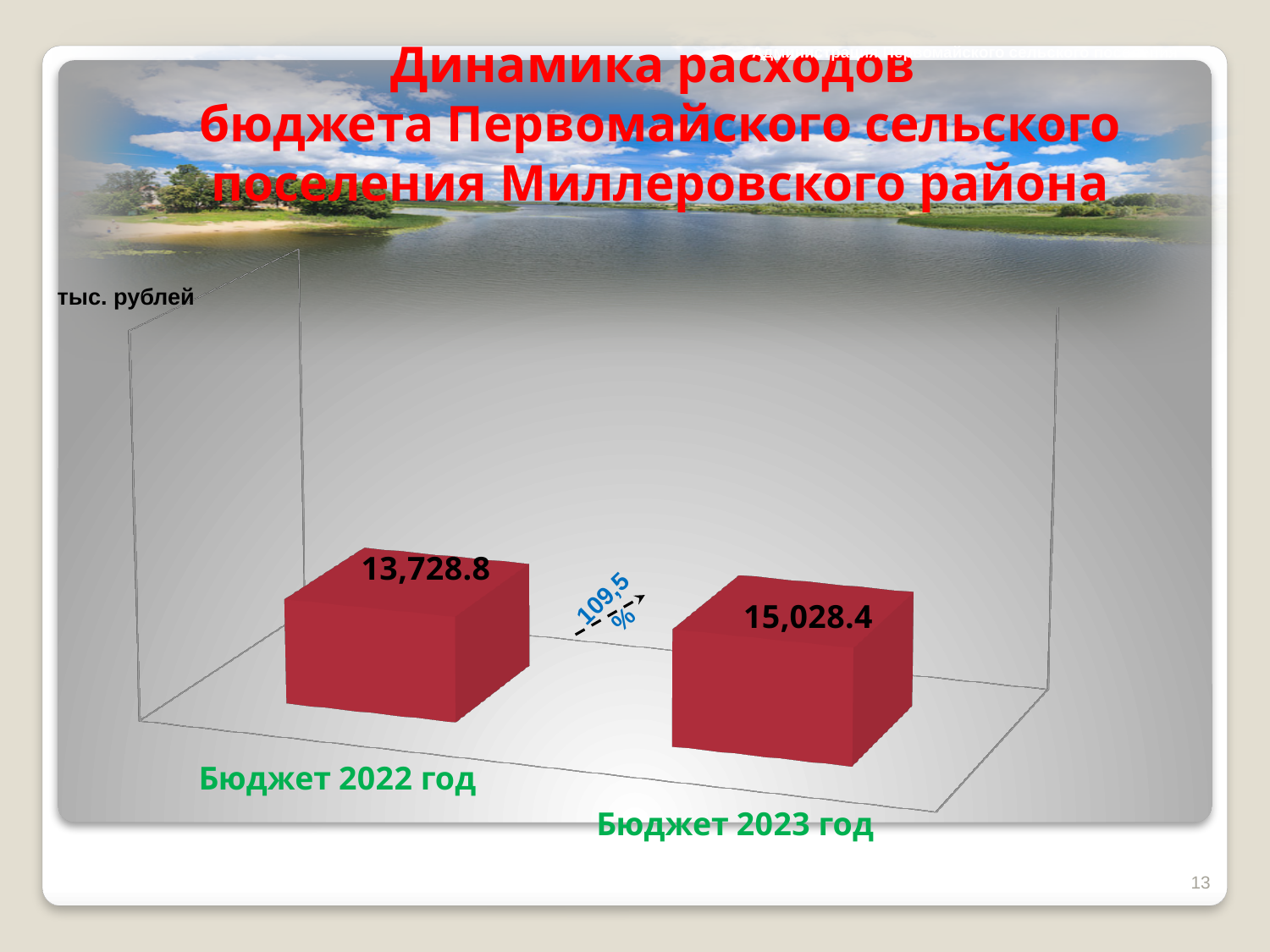
What is the difference between the values for Бюджет 2023 год and Бюджет 2022 год? 1,299.6 Which is larger, the value for Бюджет 2022 год or Бюджет 2023 год? Бюджет 2023 год Do the values rise or fall from Бюджет 2022 год to Бюджет 2023 год? Rise What percentage is shown on the arrow between the two bars? 109,5 % What is the value for Бюджет 2023 год? 15,028.4 What kind of chart is shown on the slide? Bar chart Which category has the highest value? Бюджет 2023 год What unit of measurement is indicated on the chart? тыс. рублей Which category has the lowest value? Бюджет 2022 год What is the value for Бюджет 2022 год? 13,728.8 How many categories are shown in the chart? 2